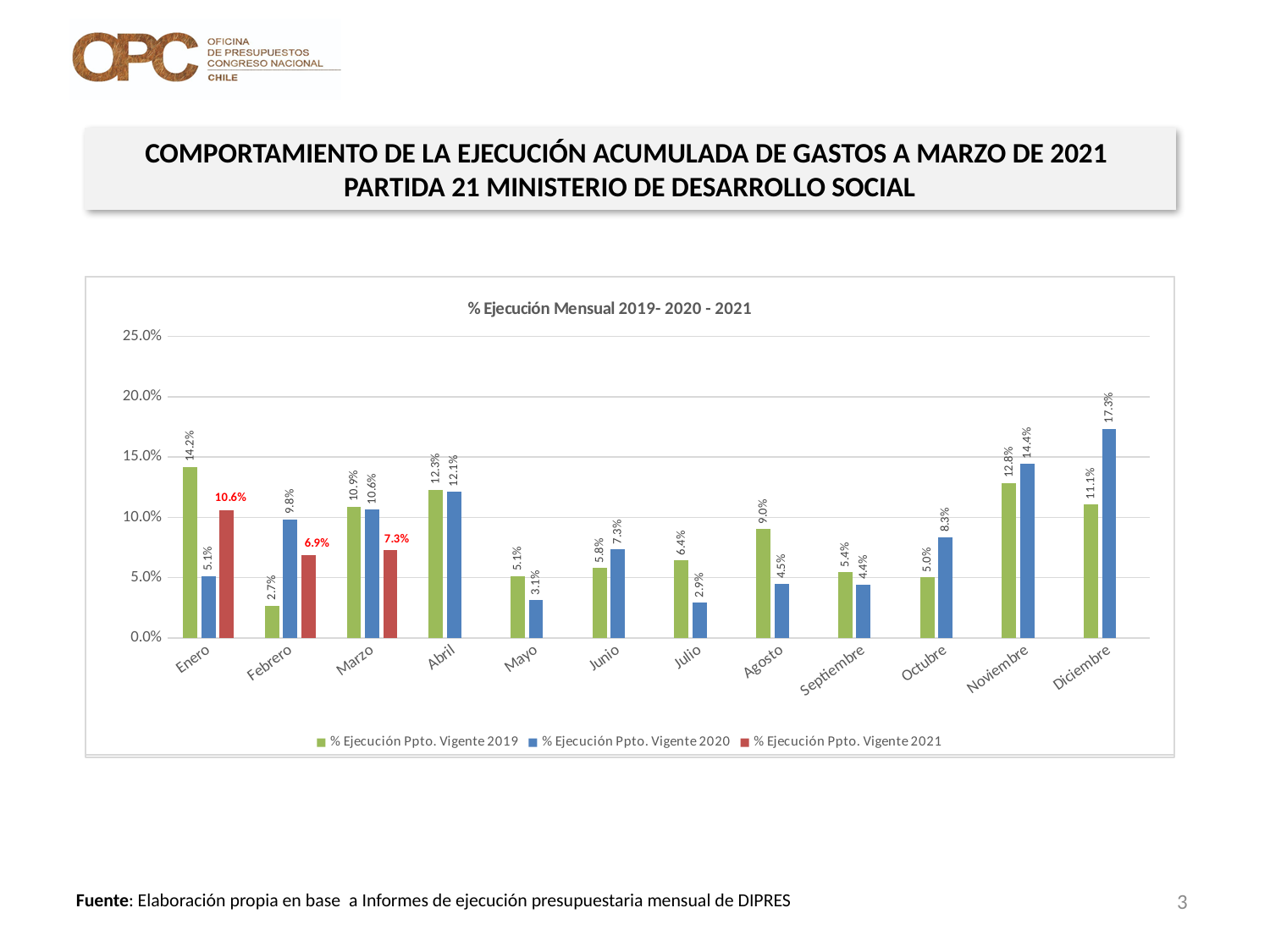
What is the value for % Ejecución Ppto. Vigente 2019 in Agosto? 9.0% What is the value for % Ejecución Ppto. Vigente 2021 in Enero? 10.6% Which month has the highest value for % Ejecución Ppto. Vigente 2019? Enero What is the difference between the 2019 and 2020 values in Enero? 9.1% What is the value for % Ejecución Ppto. Vigente 2020 in Diciembre? 17.3% Which is larger in Marzo: the 2019 value or the 2021 value? 2019 value What is the title of the chart? % Ejecución Mensual 2019- 2020 - 2021 What kind of chart is shown on the slide? Bar chart How many months are shown on the x axis? 12 How many series does the legend list? 3 Is the value for % Ejecución Ppto. Vigente 2020 in Noviembre greater or less than 10.0%? greater Which month has the lowest value for % Ejecución Ppto. Vigente 2020? Julio